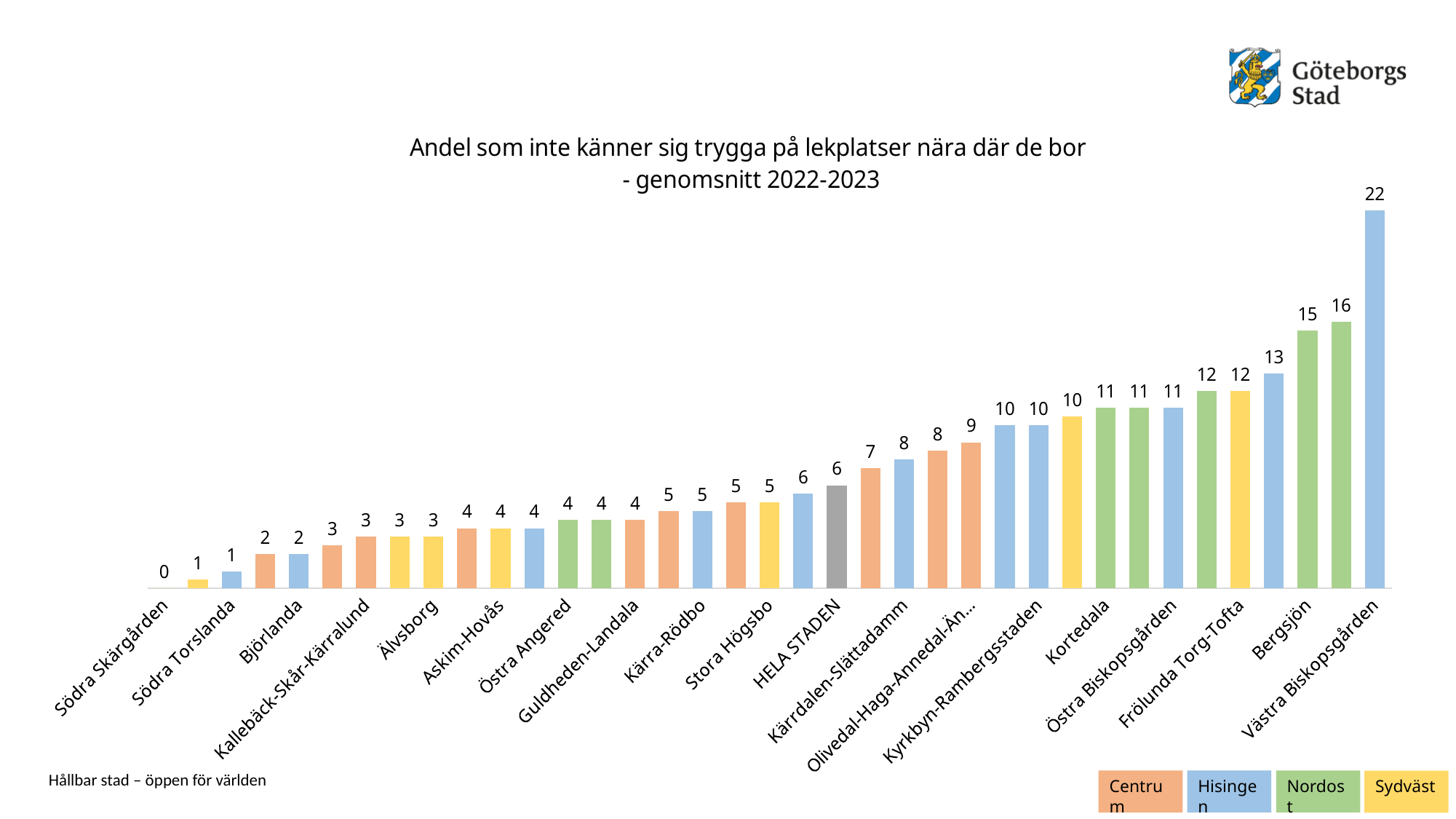
Which legend group is shown in green? Nordost Which is larger, the value for Kyrkbyn-Rambergsstaden or the value for Björlanda? Kyrkbyn-Rambergsstaden What is the value for HELA STADEN? 6 What is the difference between the values for Västra Biskopsgården and Bergsjön? 7 Which area has the lowest value in the chart? Södra Skärgården How many groups does the legend list? 4 What is the value for Kortedala? 11 What type of chart is shown on the slide? bar chart Which area has the highest share of people who do not feel safe at playgrounds near where they live? Västra Biskopsgården What is the value for Bergsjön? 15 What is the value for Västra Biskopsgården? 22 Do the values rise or fall from left to right along the x axis? rise